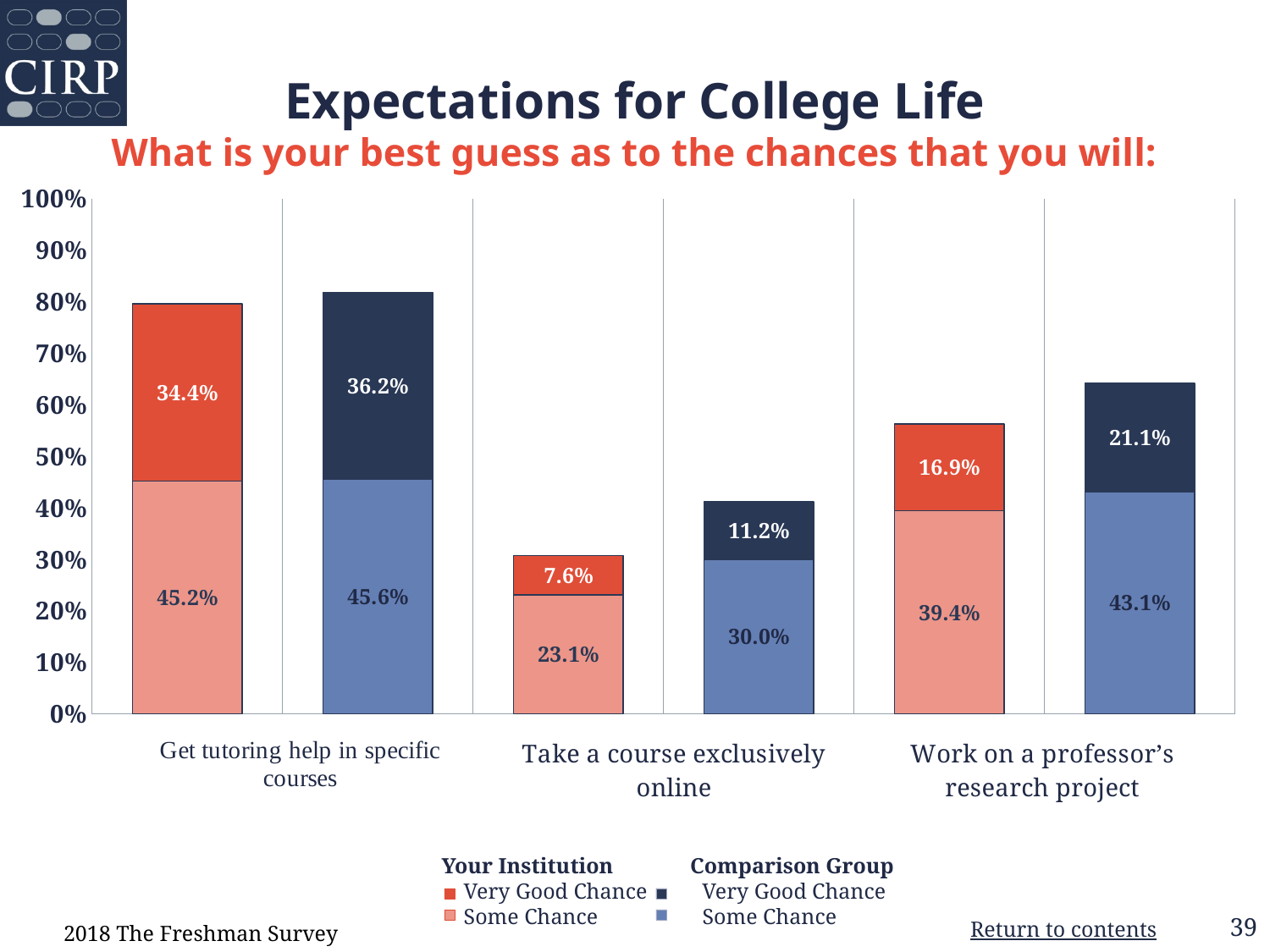
What is the 'Some Chance' value for the Comparison Group for 'Take a course exclusively online'? 30.0% Which category has the highest 'Some Chance' value for the Comparison Group? Get tutoring help in specific courses What is the difference between the Comparison Group and Your Institution 'Some Chance' values for 'Take a course exclusively online'? 6.9% What is the total of the stacked bar for Your Institution for 'Take a course exclusively online'? 30.7% What kind of chart is shown on the slide? Stacked bar chart How many series does the legend list? 4 Which category has the lowest 'Very Good Chance' value for Your Institution? Take a course exclusively online What is the total of the stacked bar for the Comparison Group for 'Get tutoring help in specific courses'? 81.8% For 'Work on a professor's research project', which is larger: the 'Very Good Chance' value for Your Institution or for the Comparison Group? Comparison Group What is the 'Very Good Chance' value for Your Institution for 'Get tutoring help in specific courses'? 34.4% What is the 'Some Chance' value for Your Institution for 'Work on a professor's research project'? 39.4% What is the 'Very Good Chance' value for the Comparison Group for 'Work on a professor's research project'? 21.1%